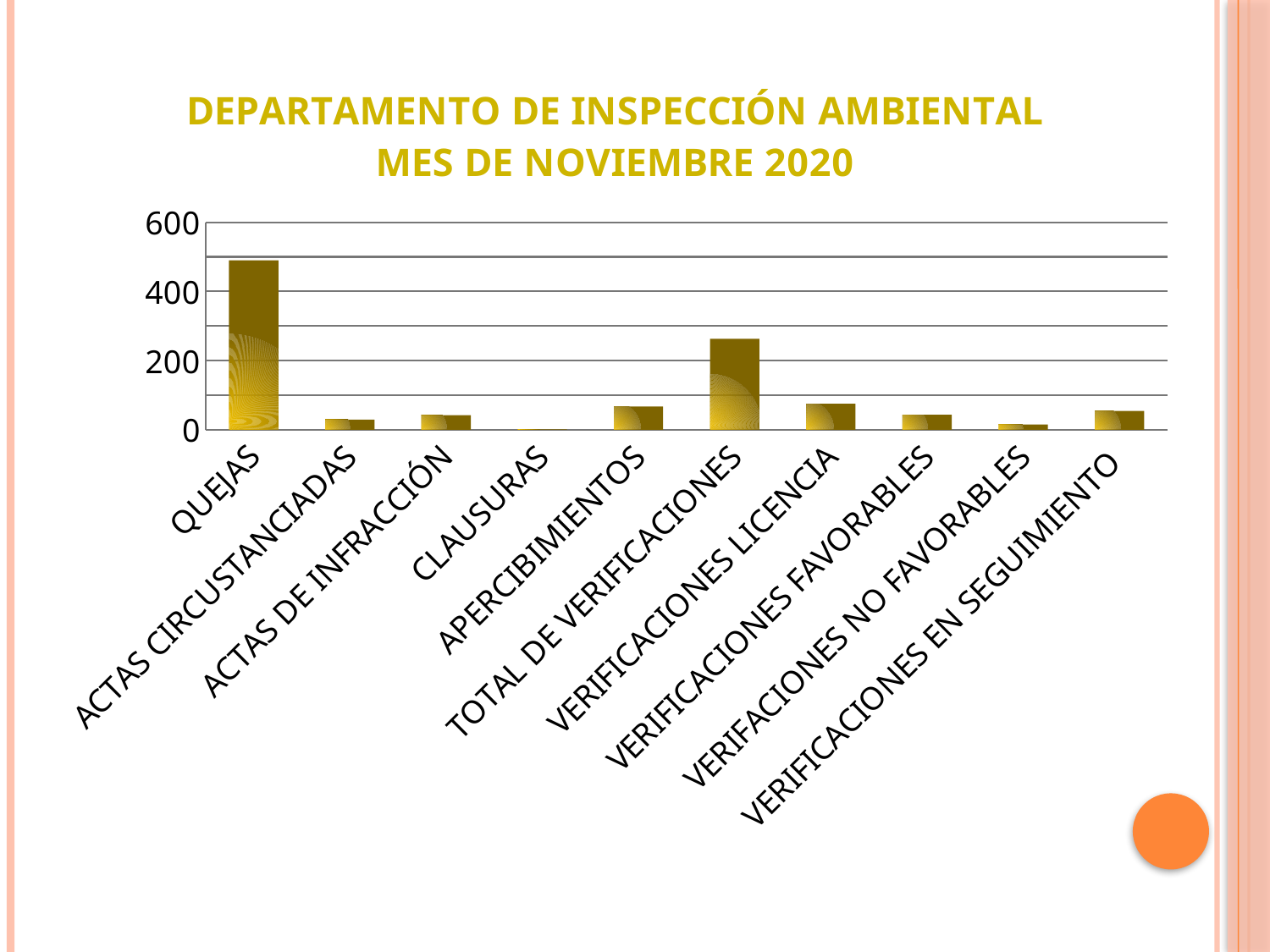
Is the value for QUEJAS greater or less than 400? greater What kind of chart is shown on the slide? bar chart How many categories are shown on the x axis of the chart? 10 What is the highest value labelled on the vertical axis of the chart? 600 Which category has the highest value in the chart? QUEJAS Is the value for TOTAL DE VERIFICACIONES greater or less than 200? greater What is the title of the chart on the slide? DEPARTAMENTO DE INSPECCIÓN AMBIENTAL MES DE NOVIEMBRE 2020 Is the value for TOTAL DE VERIFICACIONES greater or less than 400? less Which is larger, the value for VERIFICACIONES LICENCIA or the value for VERIFICACIONES NO FAVORABLES? VERIFICACIONES LICENCIA Which category has the lowest value in the chart? CLAUSURAS Which is larger, the value for QUEJAS or the value for TOTAL DE VERIFICACIONES? QUEJAS